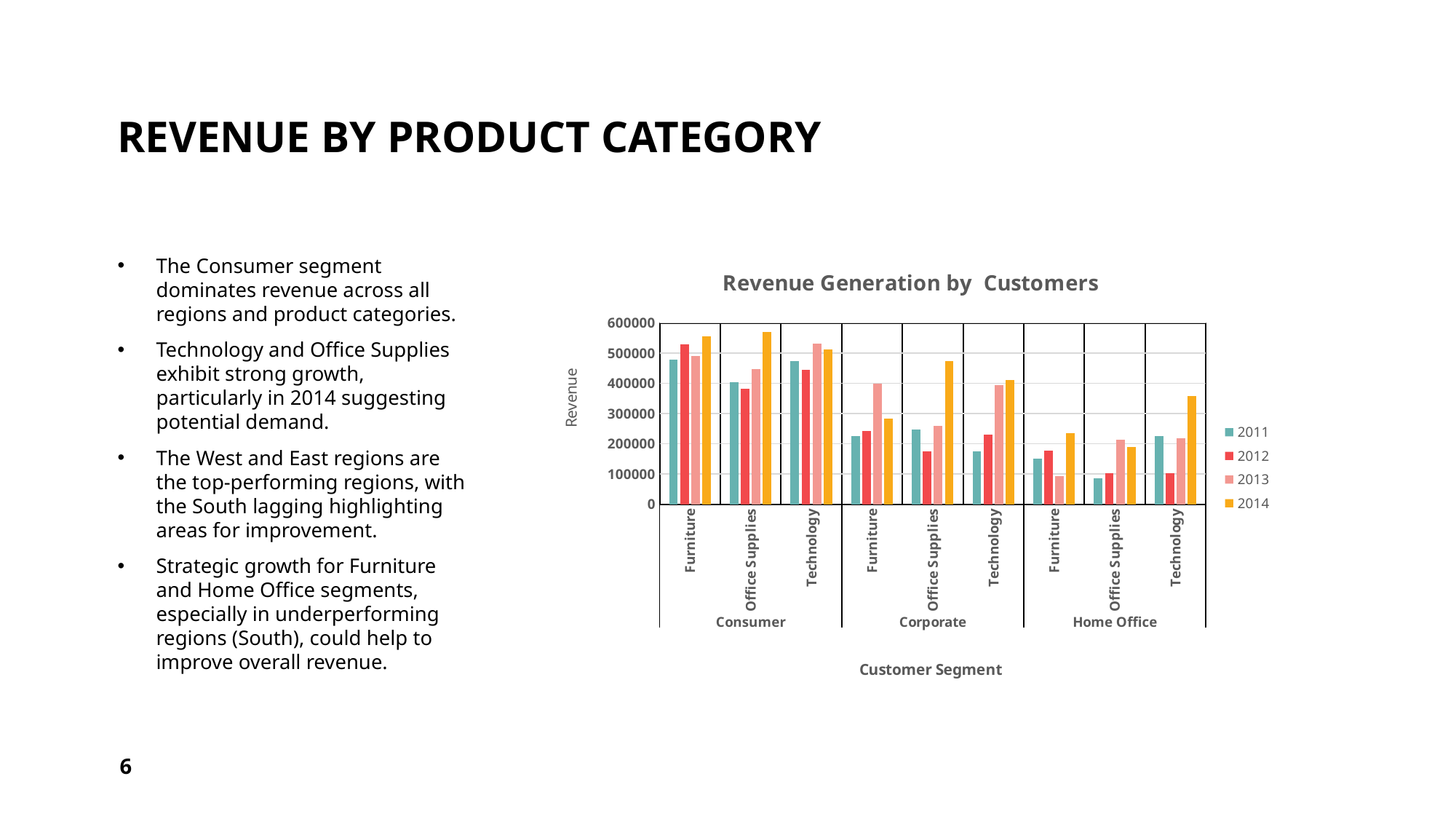
Which year has the lowest revenue for Furniture in the Home Office segment? 2013 Which year has the highest revenue for Technology in the Home Office segment? 2014 How many series does the legend of the chart list? 4 What kind of chart is shown on the slide? Bar chart Is the 2014 revenue for Office Supplies in the Consumer segment greater or less than 500000? greater Is the 2011 revenue for Office Supplies in the Home Office segment greater or less than 100000? less How many customer segments are shown along the x axis of the chart? 3 What is the title of the chart? Revenue Generation by Customers What is the label on the vertical axis of the chart? Revenue For Furniture in the Corporate segment, which year has the higher revenue, 2013 or 2014? 2013 In 2014, which has the higher revenue: Furniture in the Consumer segment or Technology in the Consumer segment? Furniture in the Consumer segment Is the 2011 revenue for Technology in the Corporate segment greater or less than 200000? less